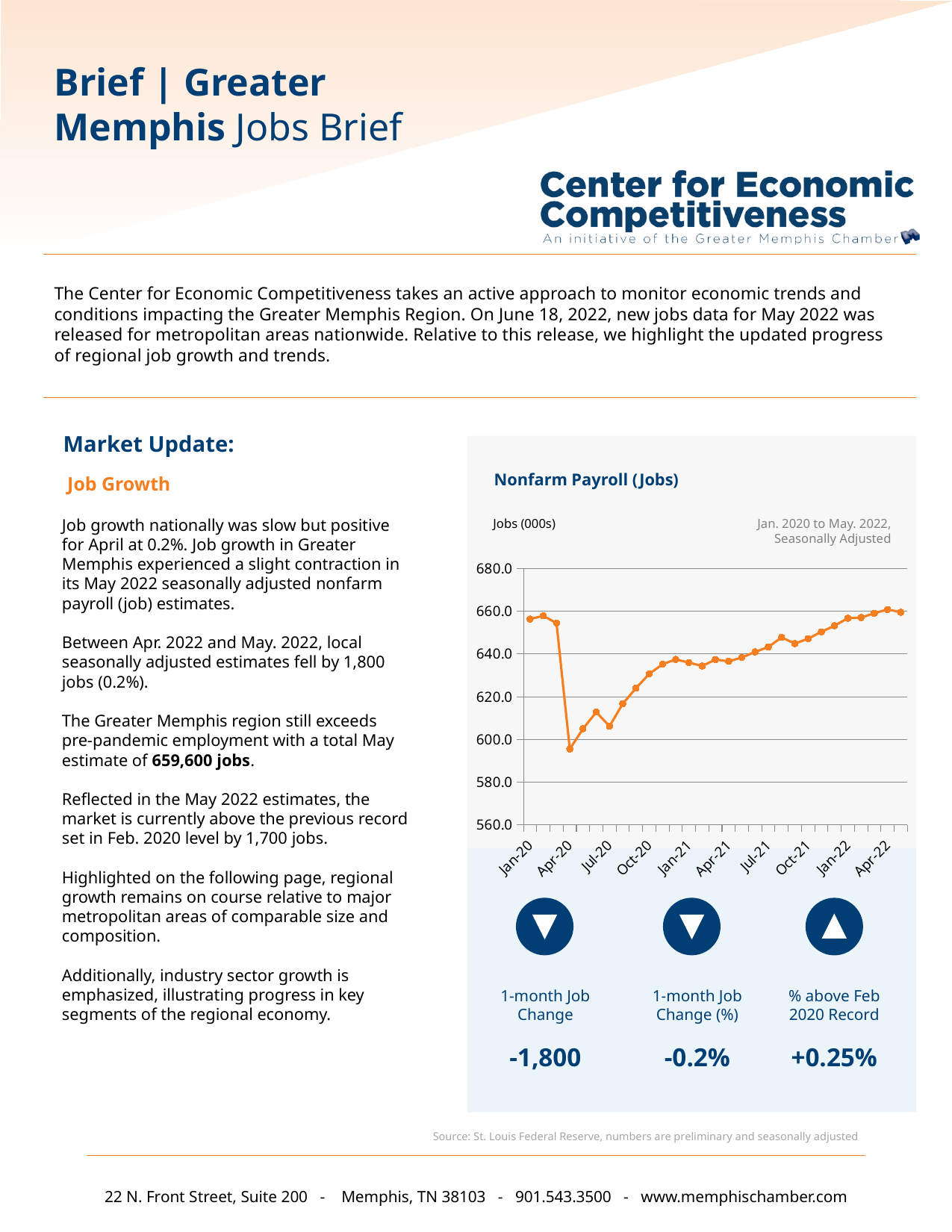
In the Nonfarm Payroll (Jobs) chart, do the values generally rise or fall from Apr-20 to Apr-22? rise How many month labels are shown on the x axis of the Nonfarm Payroll (Jobs) chart? 10 In the Nonfarm Payroll (Jobs) chart, is the value for Apr-20 greater or less than 620? less In the Nonfarm Payroll (Jobs) chart, which is larger, the value for Jan-20 or the value for Apr-20? Jan-20 In the Nonfarm Payroll (Jobs) chart, which labelled month has the lowest value? Apr-20 In the Nonfarm Payroll (Jobs) chart, is the value for Jul-20 greater or less than 620? less In the Nonfarm Payroll (Jobs) chart, is the value for Apr-22 greater or less than 640? greater What kind of chart is the Nonfarm Payroll (Jobs) chart? line chart What unit label is shown above the y axis of the Nonfarm Payroll (Jobs) chart? Jobs (000s) In the Nonfarm Payroll (Jobs) chart, which is larger, the value for Jan-21 or the value for Jan-22? Jan-22 What is the title of the chart on the slide? Nonfarm Payroll (Jobs)